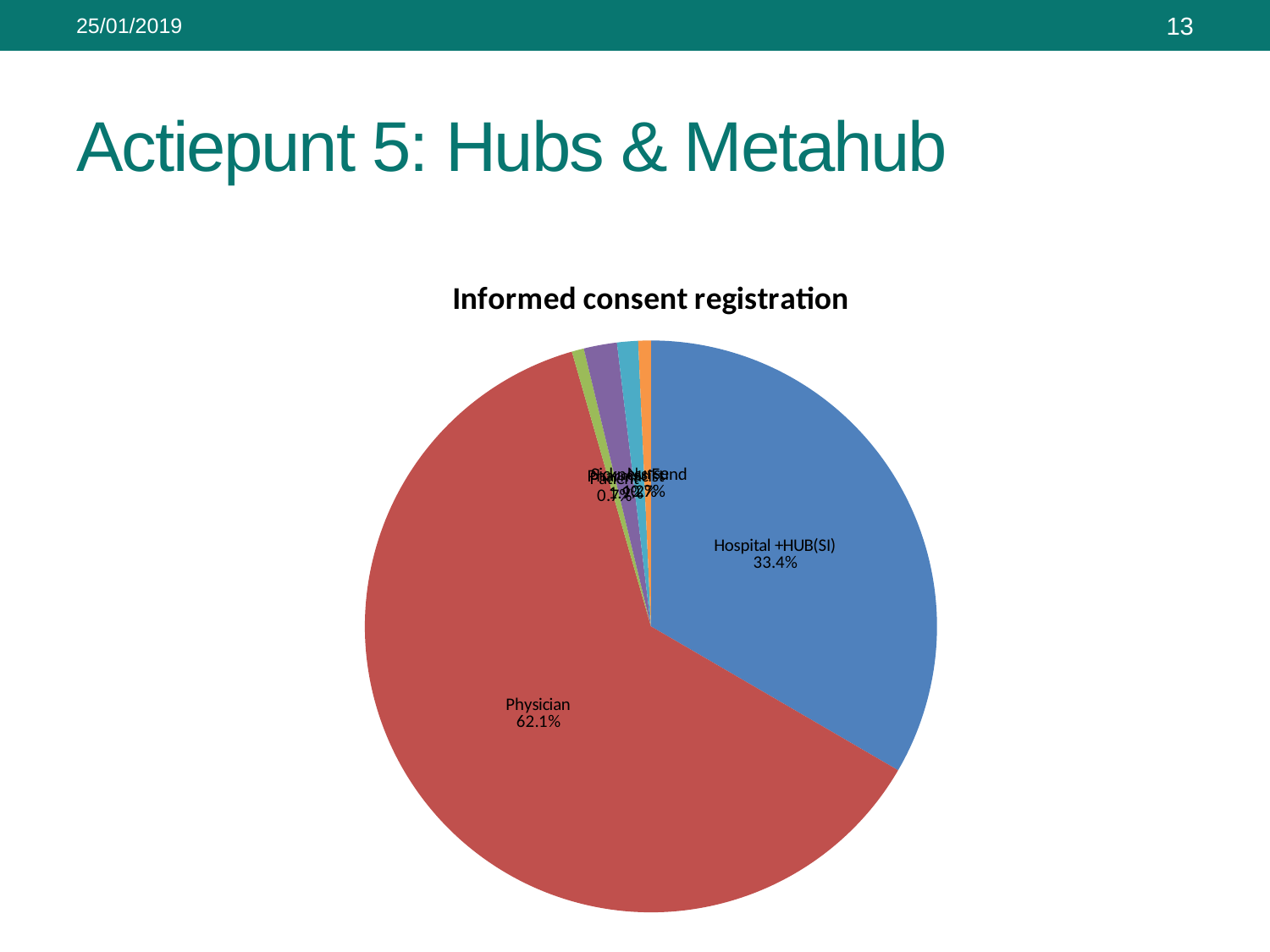
Is the Hospital +HUB(SI) share greater or less than 50%? less What is the title of the chart? Informed consent registration By how many percentage points does the Physician share exceed the Hospital +HUB(SI) share? 28.7 percentage points What percentage of the pie is labelled Hospital +HUB(SI)? 33.4% How many slices does the pie chart have? 6 What kind of chart is shown on the slide? pie chart Is the Physician share greater or less than 50%? greater Which category has the largest slice of the pie? Physician What colour is the Physician slice? red Which is larger, the Physician slice or the Hospital +HUB(SI) slice? Physician What percentage of the pie is labelled Physician? 62.1% What do the Physician and Hospital +HUB(SI) shares add up to? 95.5%